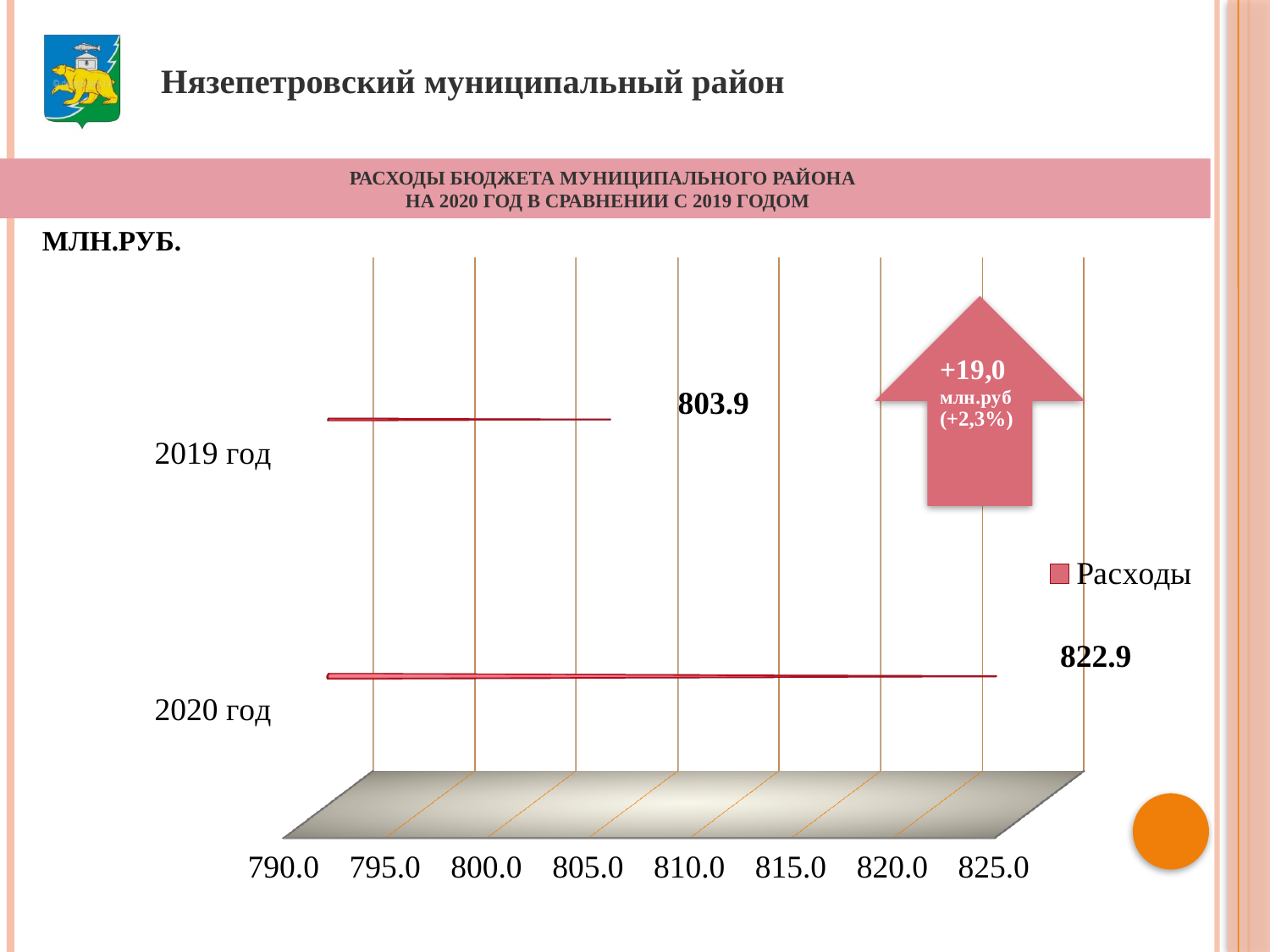
Is the value for 2019 год greater or less than 810.0? less What is the difference between the values for 2020 год and 2019 год? 19.0 Which year has the higher value? 2020 год Is the value for 2019 год larger or smaller than the value for 2020 год? smaller Is the value for 2020 год greater or less than 820.0? greater What kind of chart is shown on the slide? bar chart Which year has the lower value? 2019 год What is the value for 2020 год? 822.9 How many categories are shown in the chart? 2 How many series does the legend list? 1 What is the value for 2019 год? 803.9 What is the name of the series in the legend? Расходы